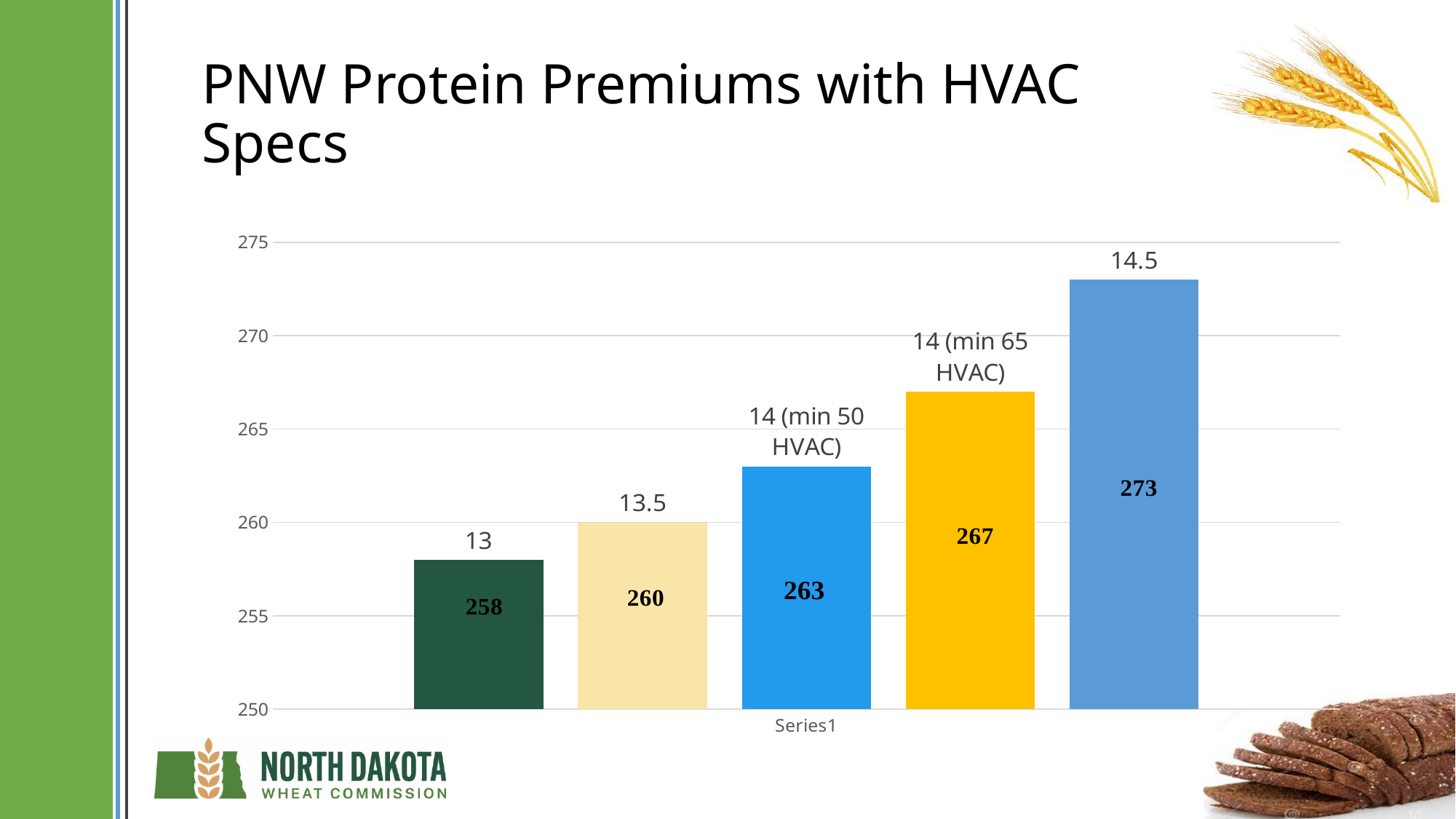
What kind of chart is shown on the slide? Bar chart What is the value shown inside the bar labeled 14 (min 65 HVAC)? 267 What is the difference between the values for the 14 (min 65 HVAC) bar and the 14 (min 50 HVAC) bar? 4 What is the difference between the values for the 14.5 bar and the 13 bar? 15 What is the value shown inside the bar labeled 13? 258 What is the value shown inside the bar labeled 14.5? 273 Which bar has the lowest value? 13 How many bars are plotted in the chart? 5 Do the bar values rise or fall from left to right across the chart? Rise Which bar has the highest value? 14.5 Which is larger, the value for 14 (min 50 HVAC) or the value for 13.5? 14 (min 50 HVAC) What is the value shown inside the bar labeled 13.5? 260